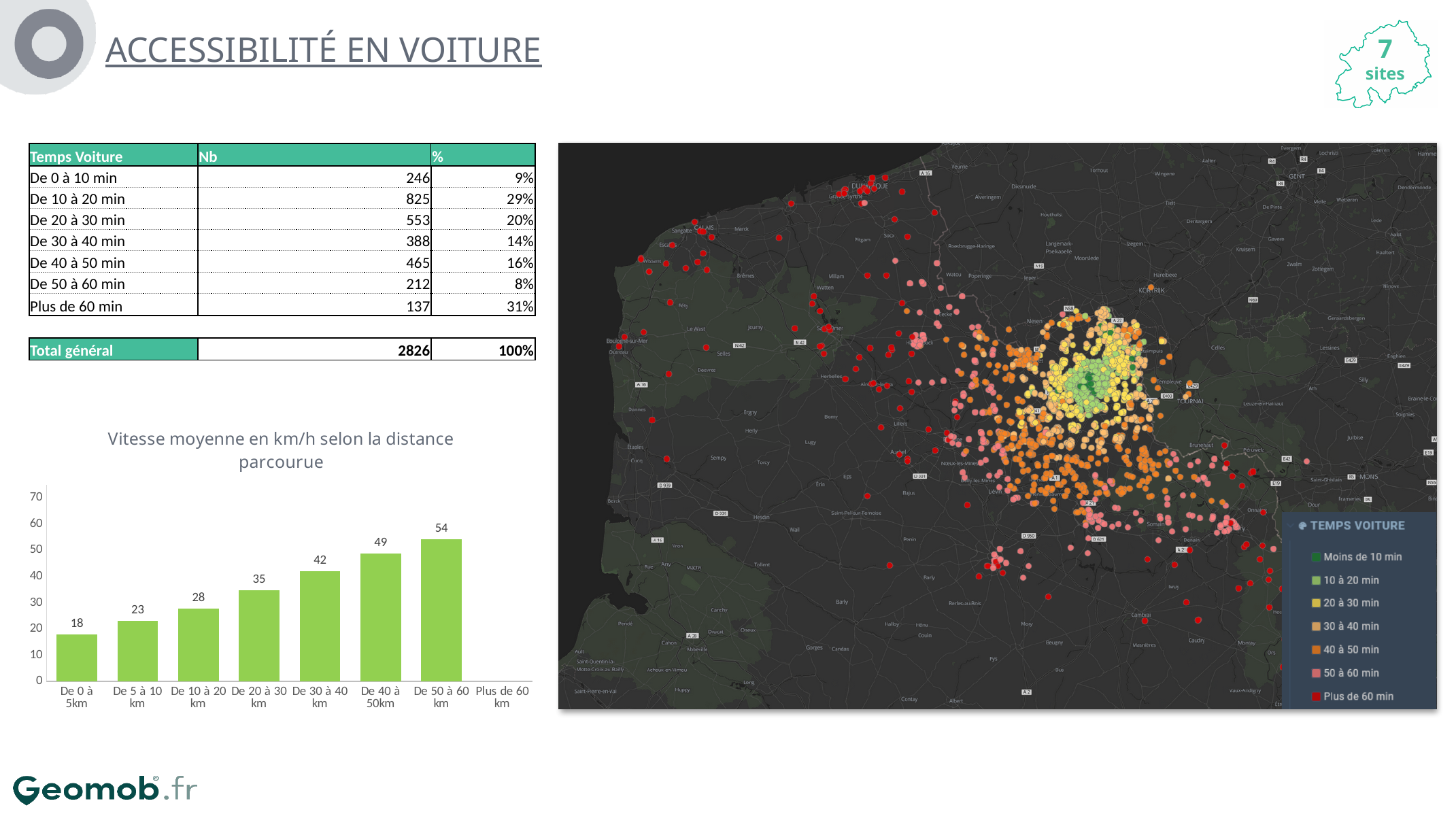
In the chart 'Vitesse moyenne en km/h selon la distance parcourue', is the value for 'De 30 à 40 km' greater or less than 40? greater In the chart 'Vitesse moyenne en km/h selon la distance parcourue', which plotted category has the lowest value? De 0 à 5km How many bars are plotted in the chart 'Vitesse moyenne en km/h selon la distance parcourue'? 7 What type of chart is 'Vitesse moyenne en km/h selon la distance parcourue'? bar chart In the chart 'Vitesse moyenne en km/h selon la distance parcourue', do the values rise or fall as distance increases along the x axis? rise In the chart 'Vitesse moyenne en km/h selon la distance parcourue', what is the value for 'De 20 à 30 km'? 35 What colour are the bars in the chart 'Vitesse moyenne en km/h selon la distance parcourue'? green In the chart 'Vitesse moyenne en km/h selon la distance parcourue', which category has the highest value? De 50 à 60 km In the chart 'Vitesse moyenne en km/h selon la distance parcourue', which is larger: the value for 'De 5 à 10 km' or 'De 10 à 20 km'? De 10 à 20 km In the chart 'Vitesse moyenne en km/h selon la distance parcourue', what is the difference between the values for 'De 40 à 50km' and 'De 30 à 40 km'? 7 In the chart 'Vitesse moyenne en km/h selon la distance parcourue', what is the value for 'De 0 à 5km'? 18 In the chart 'Vitesse moyenne en km/h selon la distance parcourue', what is the value for 'De 50 à 60 km'? 54